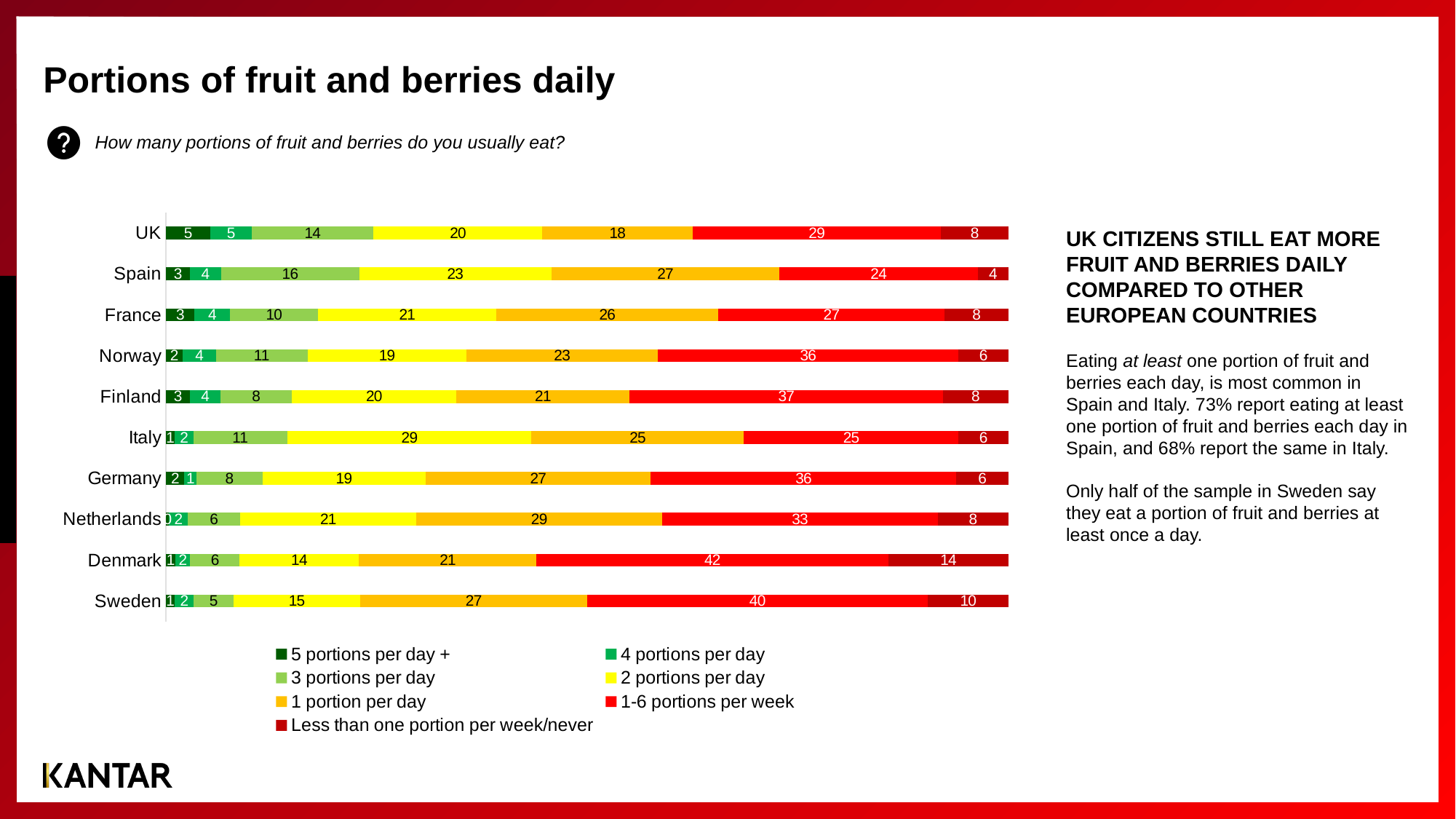
Which country has the highest value in the '5 portions per day +' series? UK What is the value for Denmark in the 'Less than one portion per week/never' series? 14 What is the value for Italy in the '2 portions per day' series? 29 How many series does the legend list? 7 How many countries are shown in the chart? 10 What is the value for Spain in the '1 portion per day' series? 27 What is the value for the UK in the '1-6 portions per week' series? 29 Which is larger: Norway's '1 portion per day' value or Germany's '1 portion per day' value? Germany What is the difference between Sweden's and the UK's values in the '1-6 portions per week' series? 11 Which country has the lowest value in the '3 portions per day' series? Sweden What kind of chart is shown on the slide? Stacked bar chart Which country has the highest value in the '1-6 portions per week' series? Denmark